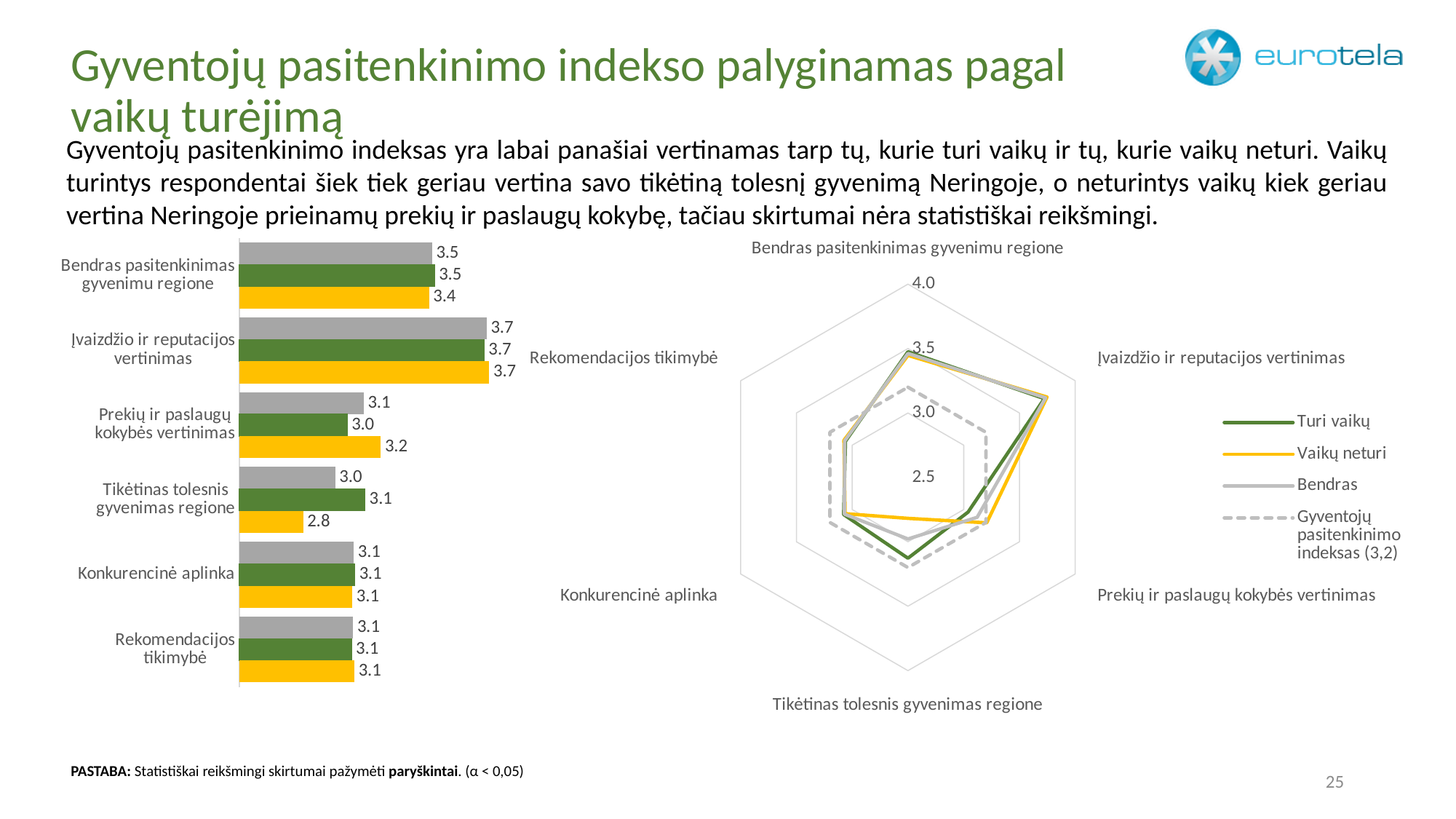
In the bar chart on the left, what is the value of the yellow bar (Vaikų neturi) for 'Tikėtinas tolesnis gyvenimas regione'? 2.8 In the bar chart on the left, what is the difference between the green bar (Turi vaikų) and the yellow bar (Vaikų neturi) for 'Tikėtinas tolesnis gyvenimas regione'? 0.3 In the bar chart on the left, for 'Prekių ir paslaugų kokybės vertinimas', which is larger: the yellow bar (Vaikų neturi) or the green bar (Turi vaikų)? the yellow bar (Vaikų neturi) In the bar chart on the left, what is the value of the grey bar (Bendras) for 'Bendras pasitenkinimas gyvenimu regione'? 3.5 In the bar chart on the left, which category has the highest values across all three bars? Įvaizdžio ir reputacijos vertinimas In the bar chart on the left, what is the value of the green bar (Turi vaikų) for 'Prekių ir paslaugų kokybės vertinimas'? 3.0 What kind of chart is the chart on the left side of the slide? bar chart How many series does the legend of the radar chart on the right list? 4 How many axes (categories) does the radar chart on the right have? 6 In the bar chart on the left, what is the lowest value shown on any bar? 2.8 In the bar chart on the left, how many categories are shown? 6 In the legend of the radar chart on the right, what value is given in parentheses for 'Gyventojų pasitenkinimo indeksas'? 3,2